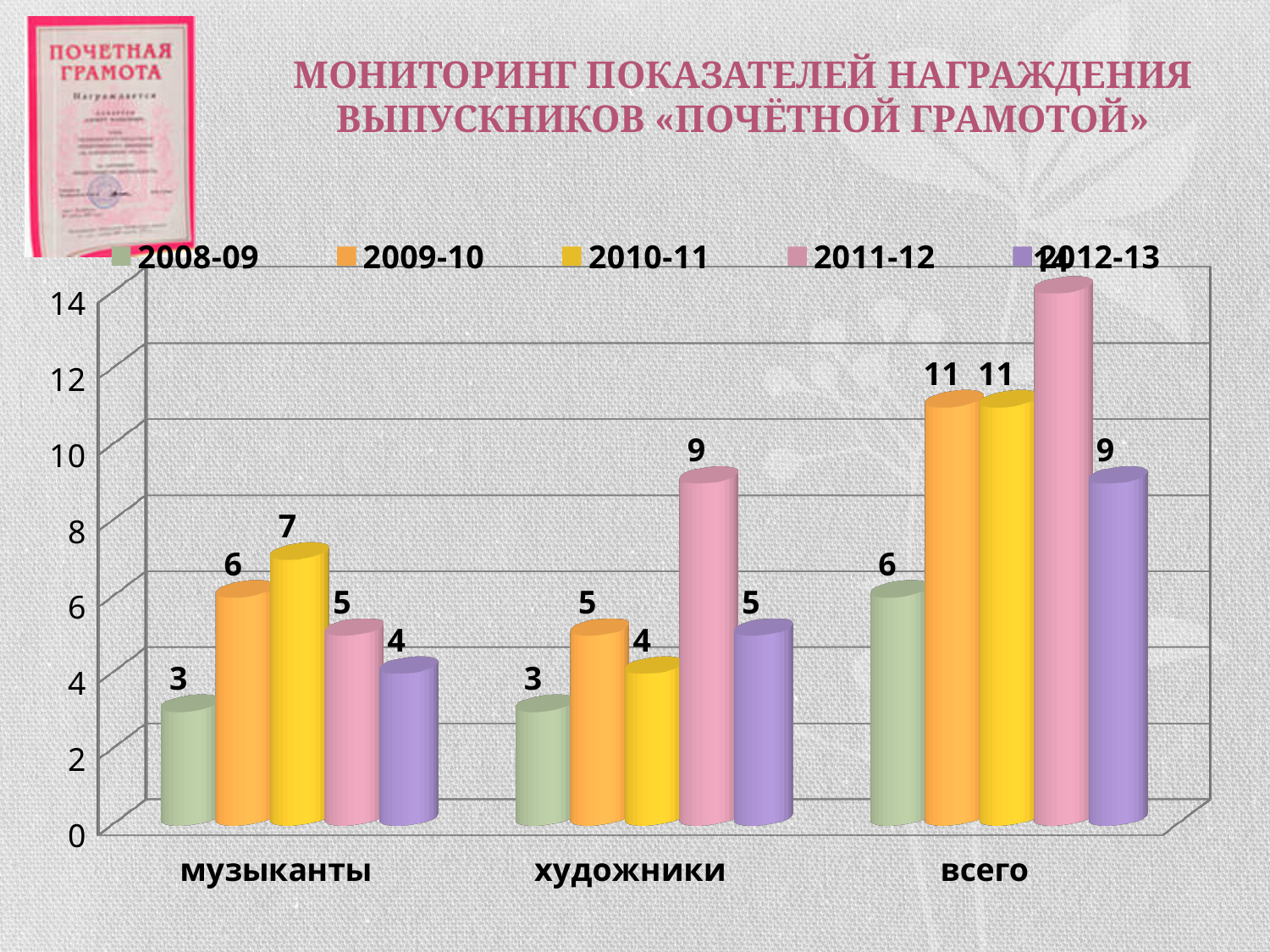
Which series has the lowest value for музыканты? 2008-09 What is the value for всего in the 2012-13 series? 9 What is the value for художники in the 2008-09 series? 3 How many series does the legend list? 5 Is the value for всего in the 2011-12 series greater or less than 12? greater How many categories are shown on the x axis? 3 What is the value for музыканты in the 2010-11 series? 7 What is the value for художники in the 2011-12 series? 9 What kind of chart is shown on the slide? bar chart Which is larger for музыканты: the 2009-10 value or the 2012-13 value? 2009-10 What is the difference between the 2011-12 and 2008-09 values for всего? 8 Which series has the highest value for художники? 2011-12